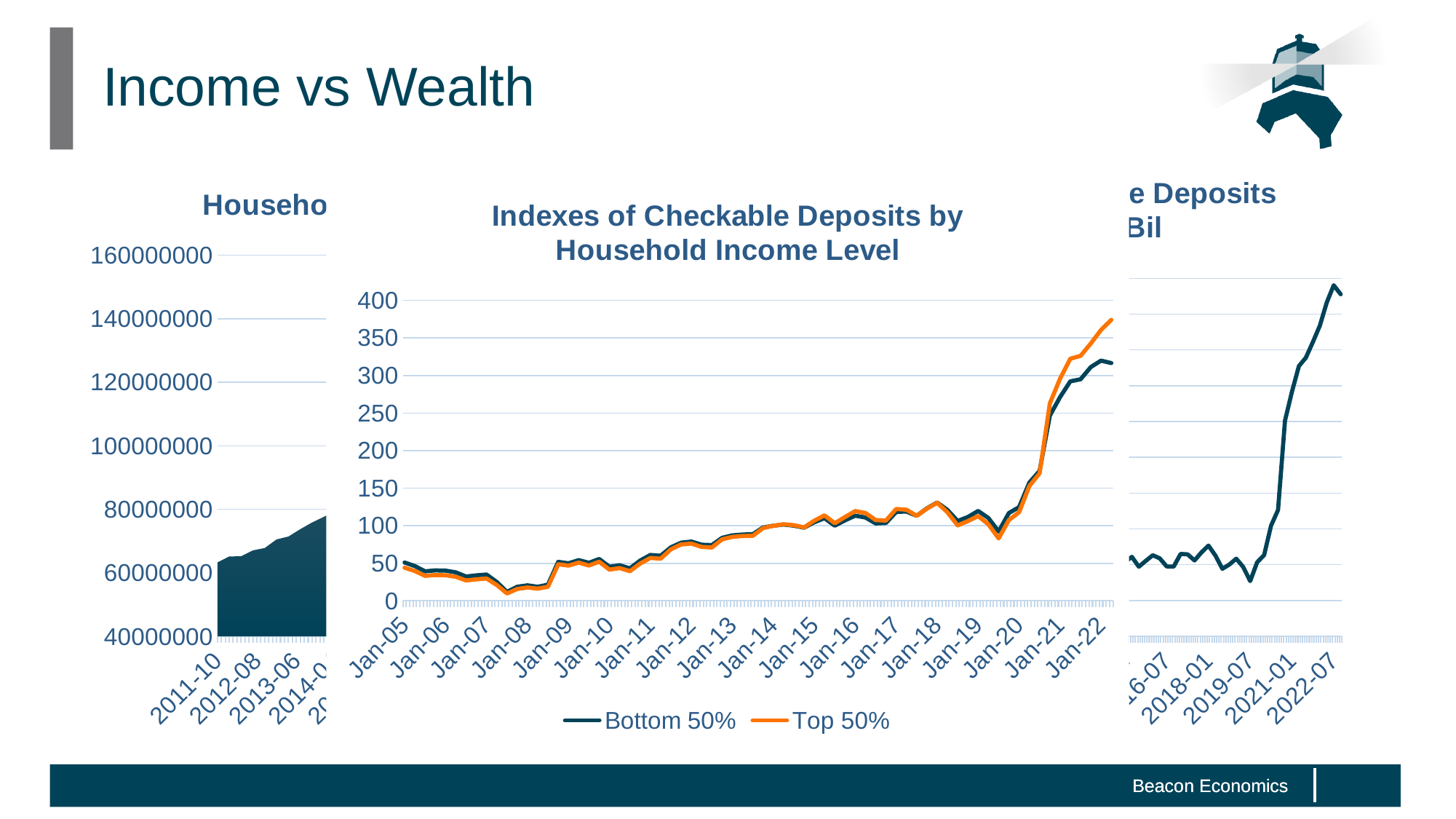
In the leftmost chart, is the value at 2011-10 greater or less than 80000000? less How many series does the legend of the 'Indexes of Checkable Deposits by Household Income Level' chart list? 2 In the 'Indexes of Checkable Deposits by Household Income Level' chart, do the values generally rise or fall from Jan-05 to Jan-22? rise In the 'Indexes of Checkable Deposits by Household Income Level' chart, is the Top 50% value at Jan-22 greater or less than 350? greater In the 'Indexes of Checkable Deposits by Household Income Level' chart, is the Bottom 50% value at Jan-20 greater or less than 150? less What kind of chart is the leftmost chart on the slide? area chart What kind of chart is the middle chart titled 'Indexes of Checkable Deposits by Household Income Level'? line chart In the rightmost chart, do the values rise or fall between 2019-07 and 2022-07? rise In the 'Indexes of Checkable Deposits by Household Income Level' chart, which series has the higher value at Jan-22, Bottom 50% or Top 50%? Top 50% In the 'Indexes of Checkable Deposits by Household Income Level' chart, which series is shown in orange? Top 50%